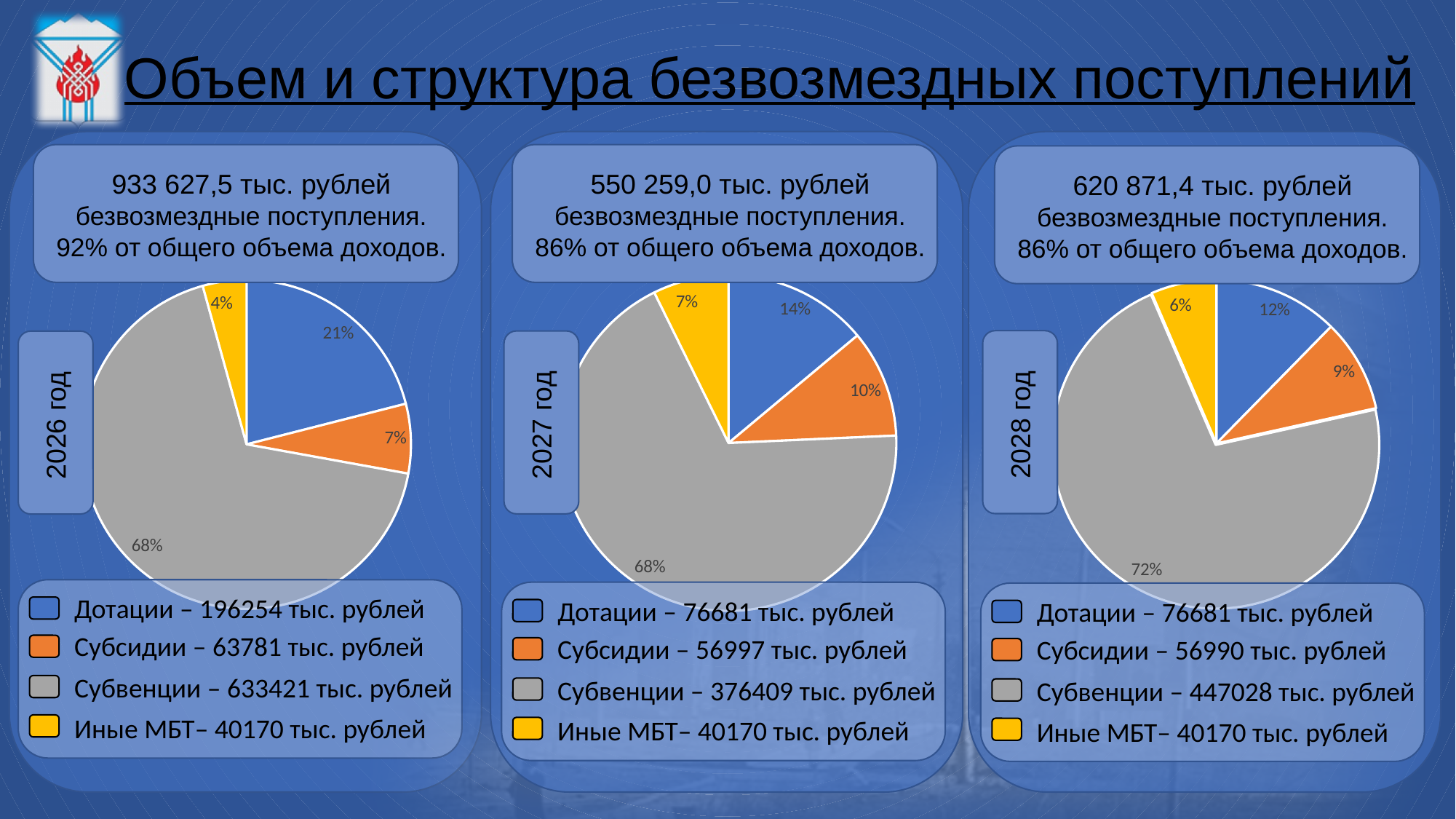
In the 2028 год chart, what is the value for Субсидии according to the legend? 56990 тыс. рублей How many slices does the 2028 год pie chart have? 4 In the 2027 год pie chart, which slice is larger: Субсидии or Иные МБТ? Субсидии In the 2027 год pie chart, what share does the Дотации slice have? 14% In the 2026 год pie chart, what share does the Субвенции slice have? 68% In the 2028 год pie chart, what share does the Иные МБТ slice have? 6% In the 2028 год pie chart, which category has the largest slice? Субвенции In the 2026 год pie chart, what is the difference in percentage points between the Дотации and Субсидии slices? 14 In the 2026 год chart, what is the value for Дотации according to the legend? 196254 тыс. рублей What type of chart is used for each year on the slide? Pie chart In the 2027 год chart, what is the value for Субвенции according to the legend? 376409 тыс. рублей In the 2026 год pie chart, which category has the smallest slice? Иные МБТ